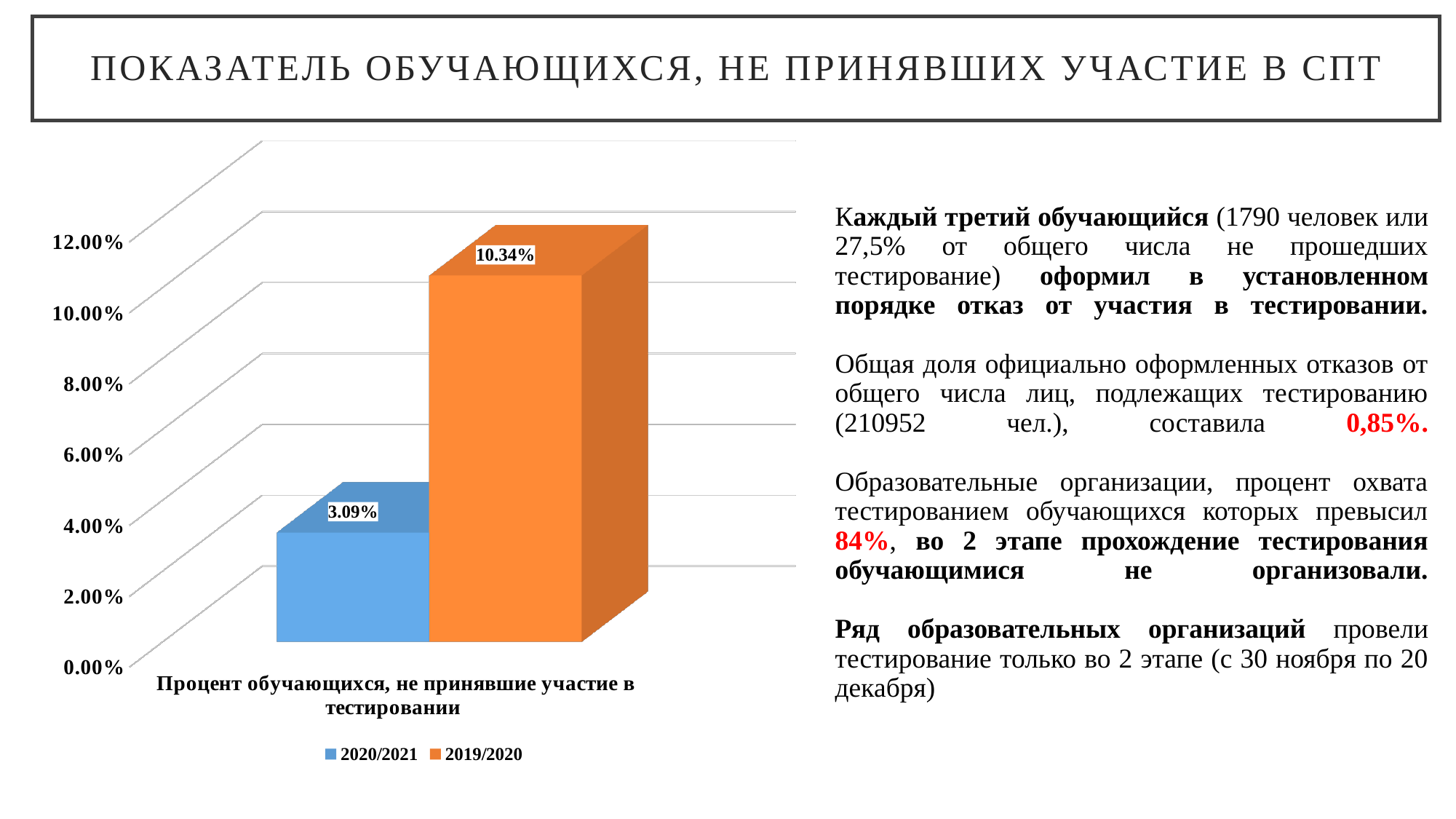
What colour is the bar for the 2019/2020 series? Orange Which series has the highest value in the chart? 2019/2020 What is the value for the 2019/2020 series in the chart? 10.34% Is the value for 2019/2020 greater or less than 8.00%? greater Is the value for 2020/2021 greater or less than 4.00%? less How many series does the legend list? 2 What is the difference between the 2019/2020 value and the 2020/2021 value? 7.25% What is the value for the 2020/2021 series in the chart? 3.09% Which series has the higher value, 2020/2021 or 2019/2020? 2019/2020 How many categories are shown on the x axis of the chart? 1 Which series has the lowest value in the chart? 2020/2021 What kind of chart is shown on the slide? Bar chart